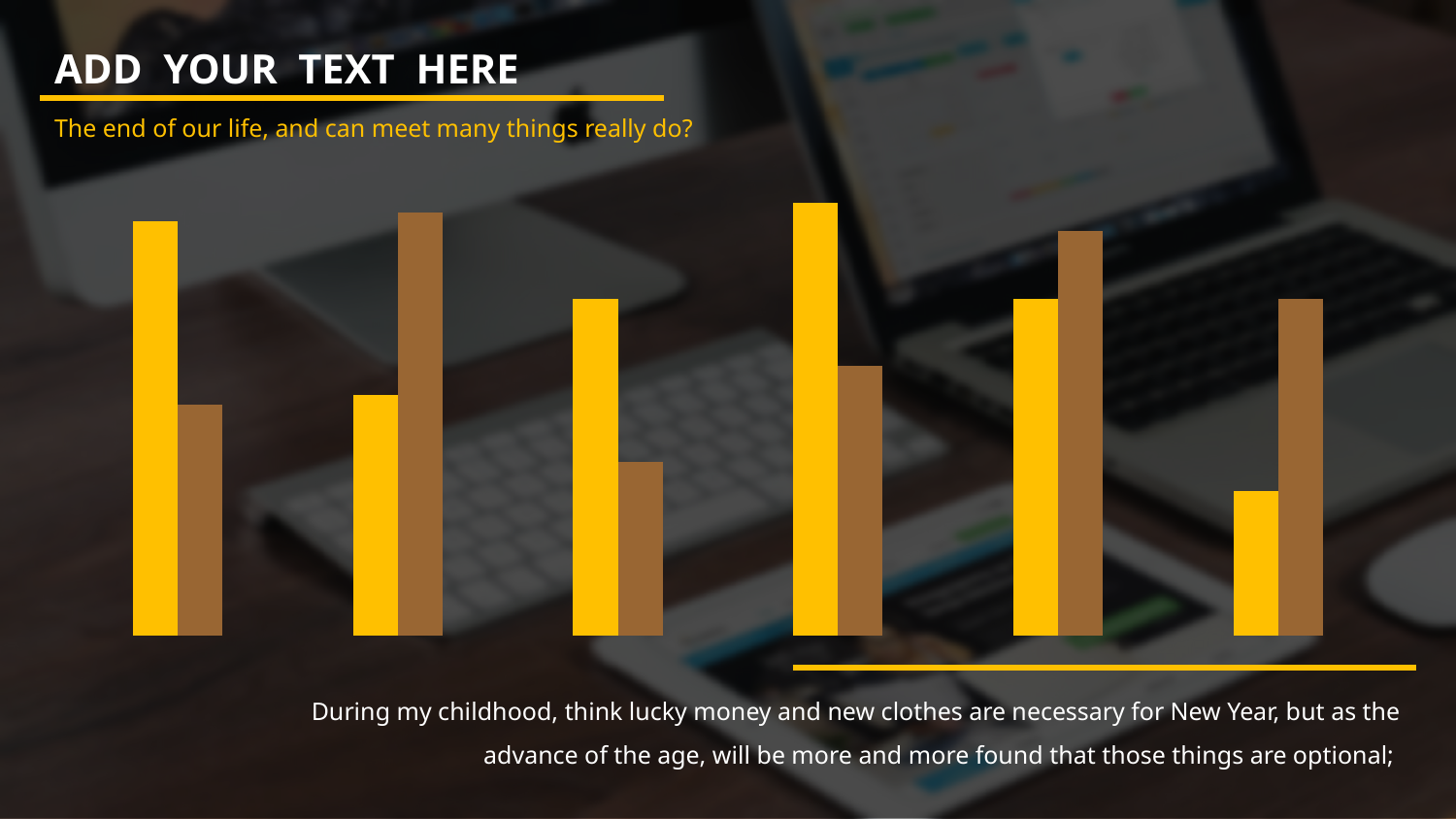
What kind of chart is shown on the slide? bar chart In the second group from the left, which bar is taller, the yellow one or the brown one? the brown one In the sixth group from the left, which bar is taller, the yellow one or the brown one? the brown one Does the chart display any data labels or axis values? No Which group from the left has the tallest yellow bar? the fourth group In the third group from the left, which bar is taller, the yellow one or the brown one? the yellow one What two colours are used for the bars in the chart? yellow and brown Which group from the left has the shortest yellow bar? the sixth group How many groups of bars does the chart contain? 6 Which group from the left has the shortest brown bar? the third group How many bars are in each group of the chart? 2